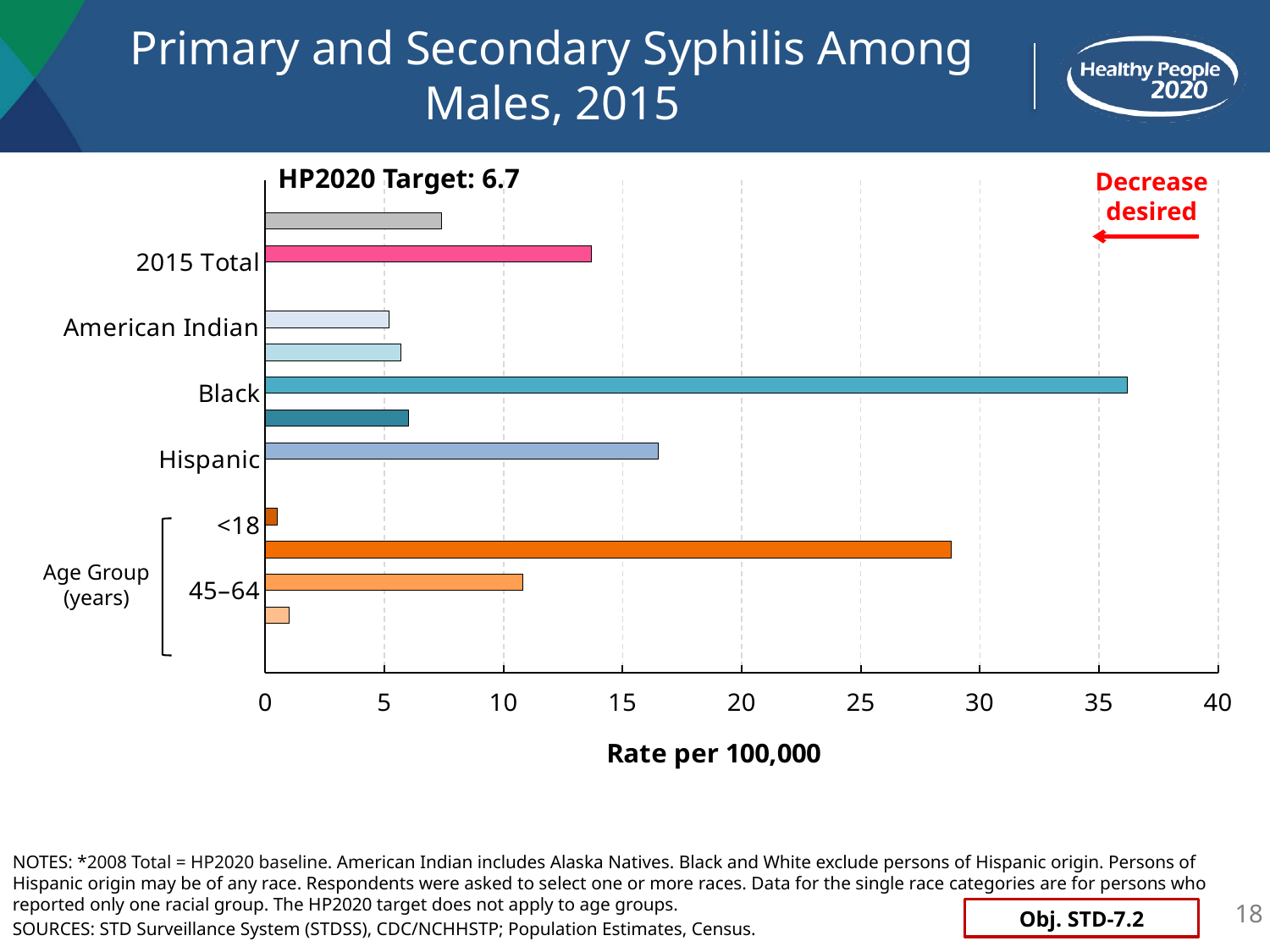
Which is larger, the rate for Hispanic males or the 2015 Total rate? Hispanic What kind of chart is shown on the slide? bar chart Is the rate for American Indian males greater or less than 10 per 100,000? less Is the rate for Black males greater or less than 35 per 100,000? greater Is the rate for Hispanic males greater or less than 15 per 100,000? greater Which labeled group has the lowest rate of primary and secondary syphilis among males? <18 Which is larger, the rate for American Indian males or the rate for males aged 45–64? 45–64 Which labeled group has the highest rate of primary and secondary syphilis among males? Black What is the HP2020 target shown on the chart? 6.7